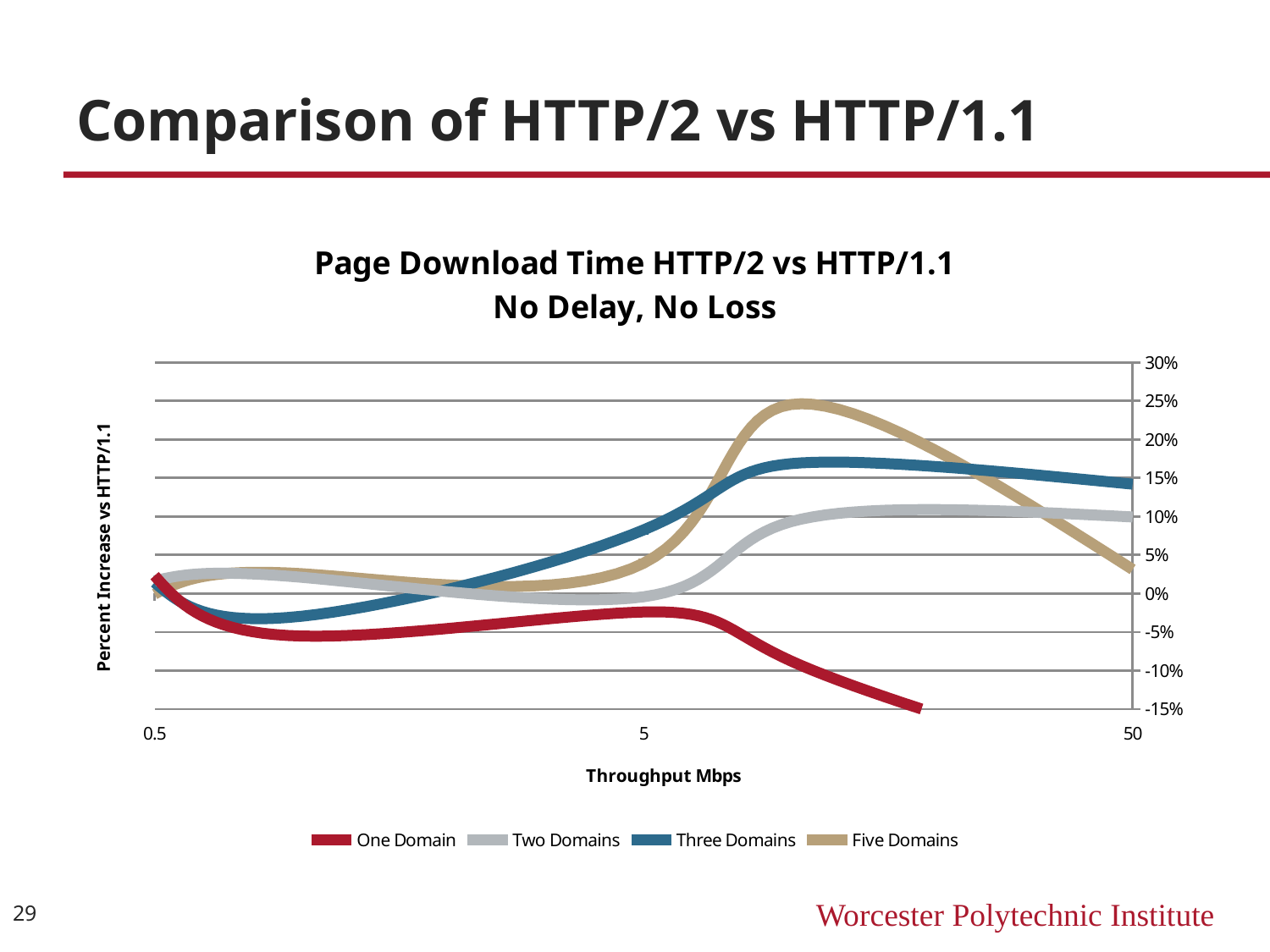
What is the label of the x axis? Throughput Mbps Is the value for Three Domains at 50 Mbps greater or less than 10%? greater What is the title of the chart? Page Download Time HTTP/2 vs HTTP/1.1 No Delay, No Loss At 50 Mbps, which is larger: Three Domains or Five Domains? Three Domains Is the value for One Domain at 5 Mbps greater or less than 0%? less Is the peak value of the Five Domains series greater or less than 20%? greater Which series has the lowest values on the chart? One Domain Which series reaches the highest value on the chart? Five Domains How many series does the legend list? 4 What kind of chart is shown on the slide? line chart Does the One Domain series rise or fall after 5 Mbps? fall